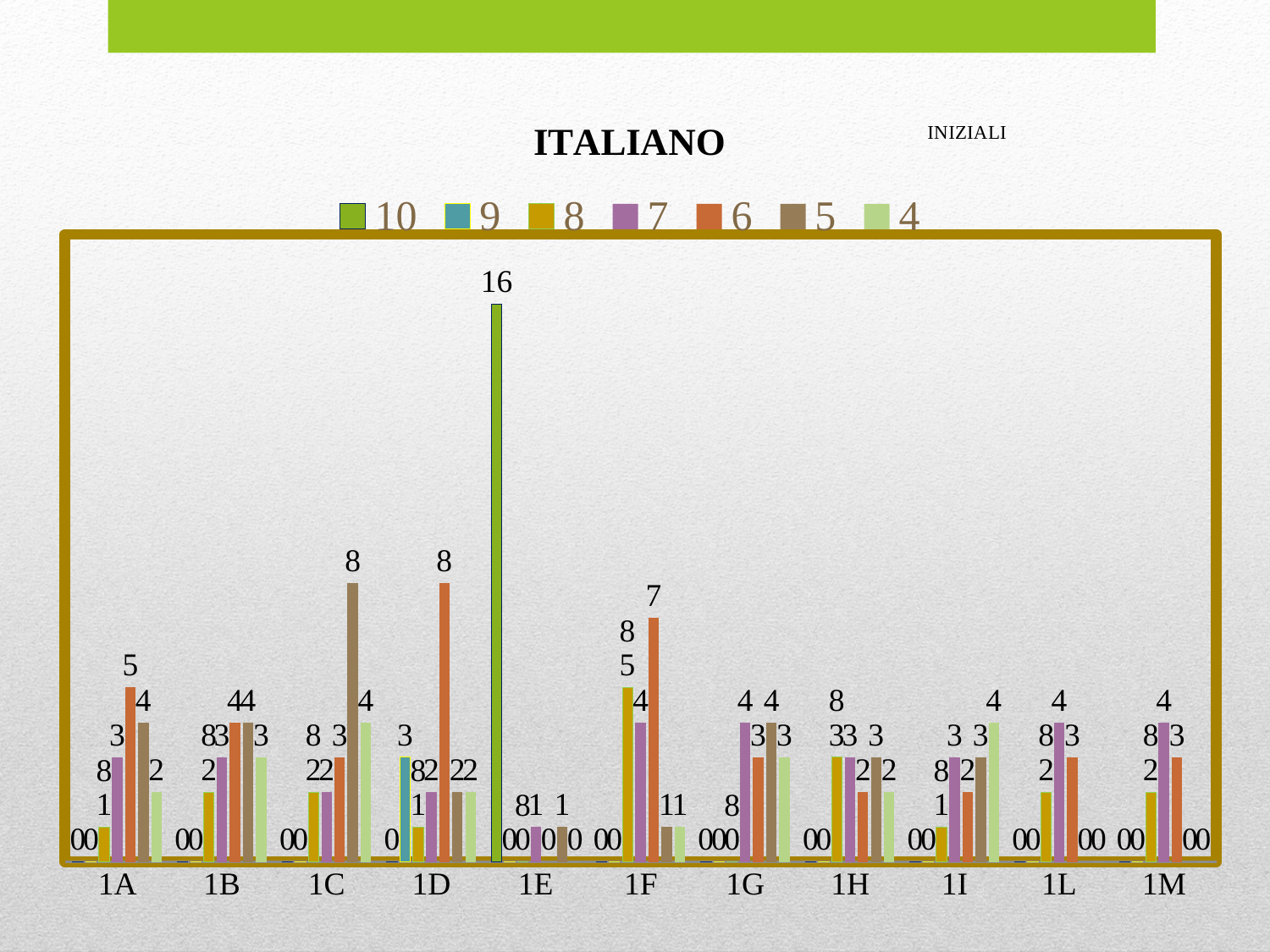
For category 1C, which is larger: the value of series 5 or the value of series 4? series 5 How many series does the legend list? 7 What is the highest value labeled on the chart? 16 What is the value of series 5 for category 1C? 8 What is the value of series 6 for category 1F? 7 How many categories are shown on the x axis? 11 What is the value of series 4 for category 1I? 4 For category 1F, what is the difference between the value of series 6 and the value of series 8? 2 What is the title of the chart? ITALIANO What kind of chart is shown on the slide? bar chart What is the value of series 6 for category 1A? 5 What is the value of series 6 for category 1D? 8